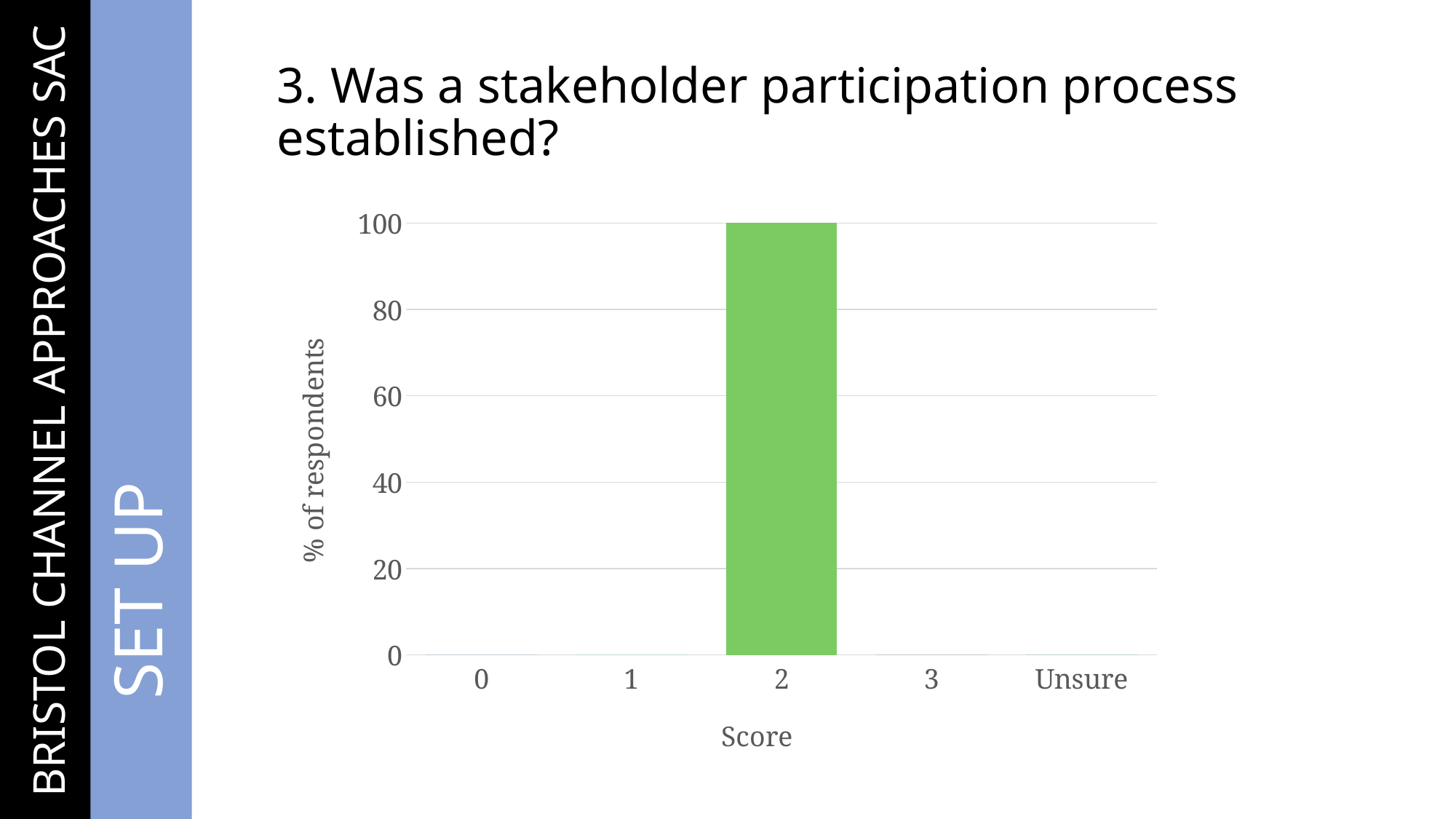
Which score category has the highest percentage of respondents? 2 Is the value for score 3 greater or less than 20? less What is the label of the x axis? Score Is the value for Unsure greater or less than 20? less What is the label of the y axis? % of respondents What kind of chart is shown on the slide? bar chart Which is larger, the value for score 2 or the value for score 1? score 2 Which is larger, the value for score 0 or the value for score 2? score 2 How many categories are shown on the x axis? 5 What is the highest value shown on the y axis? 100 Is the value for score 2 greater or less than 80? greater What is the value for score 2? 100